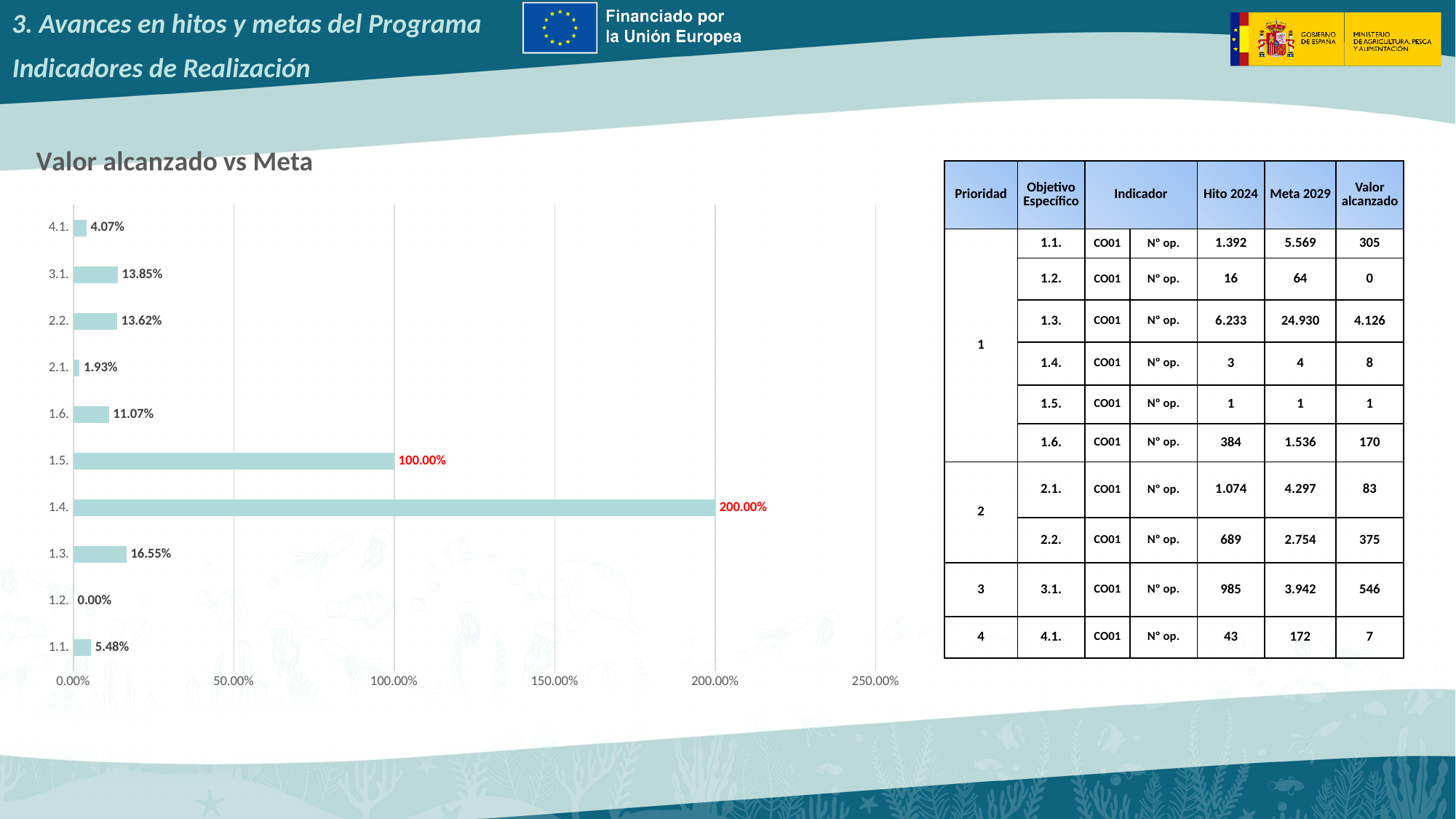
What is the value for 3.1. in the 'Valor alcanzado vs Meta' chart? 13.85% Which category has the highest value in the 'Valor alcanzado vs Meta' chart? 1.4. What kind of chart is 'Valor alcanzado vs Meta'? Bar chart What is the difference between the values for 2.2. and 2.1. in the 'Valor alcanzado vs Meta' chart? 11.69% What is the difference between the values for 1.4. and 1.5. in the 'Valor alcanzado vs Meta' chart? 100.00% What is the value for 1.1. in the 'Valor alcanzado vs Meta' chart? 5.48% How many categories are shown in the 'Valor alcanzado vs Meta' chart? 10 What is the title of the chart on the slide? Valor alcanzado vs Meta Which category has the lowest value in the 'Valor alcanzado vs Meta' chart? 1.2. Which is larger in the 'Valor alcanzado vs Meta' chart, the value for 1.3. or the value for 1.6.? 1.3. Is the value for 1.5. in the 'Valor alcanzado vs Meta' chart greater or less than 150.00%? less What is the value for 1.4. in the 'Valor alcanzado vs Meta' chart? 200.00%